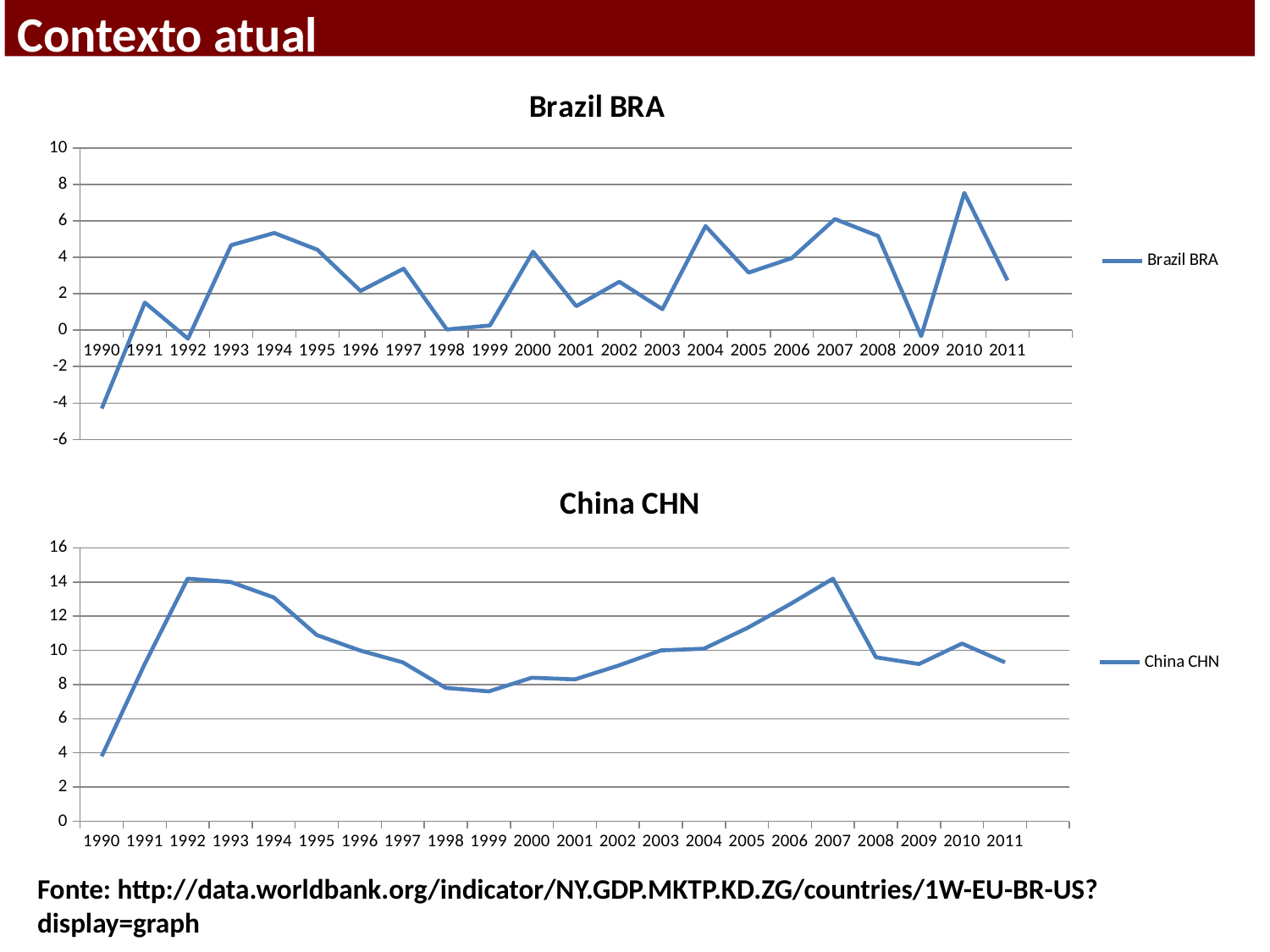
In the Brazil BRA chart, which year has the highest value? 2010 In the Brazil BRA chart, is the value for 1990 greater or less than -2? less What kind of chart is the Brazil BRA chart? line chart In the Brazil BRA chart, is the value for 2010 greater or less than 6? greater In the China CHN chart, do the values rise or fall from 1992 to 1999? fall In the China CHN chart, is the value for 1999 greater or less than 8? less In the Brazil BRA chart, which year has the lowest value? 1990 How many series does the legend of the Brazil BRA chart list? 1 In the China CHN chart, which year has the lowest value? 1990 What is the title of the lower chart on the slide? China CHN How many years are plotted on the China CHN chart? 22